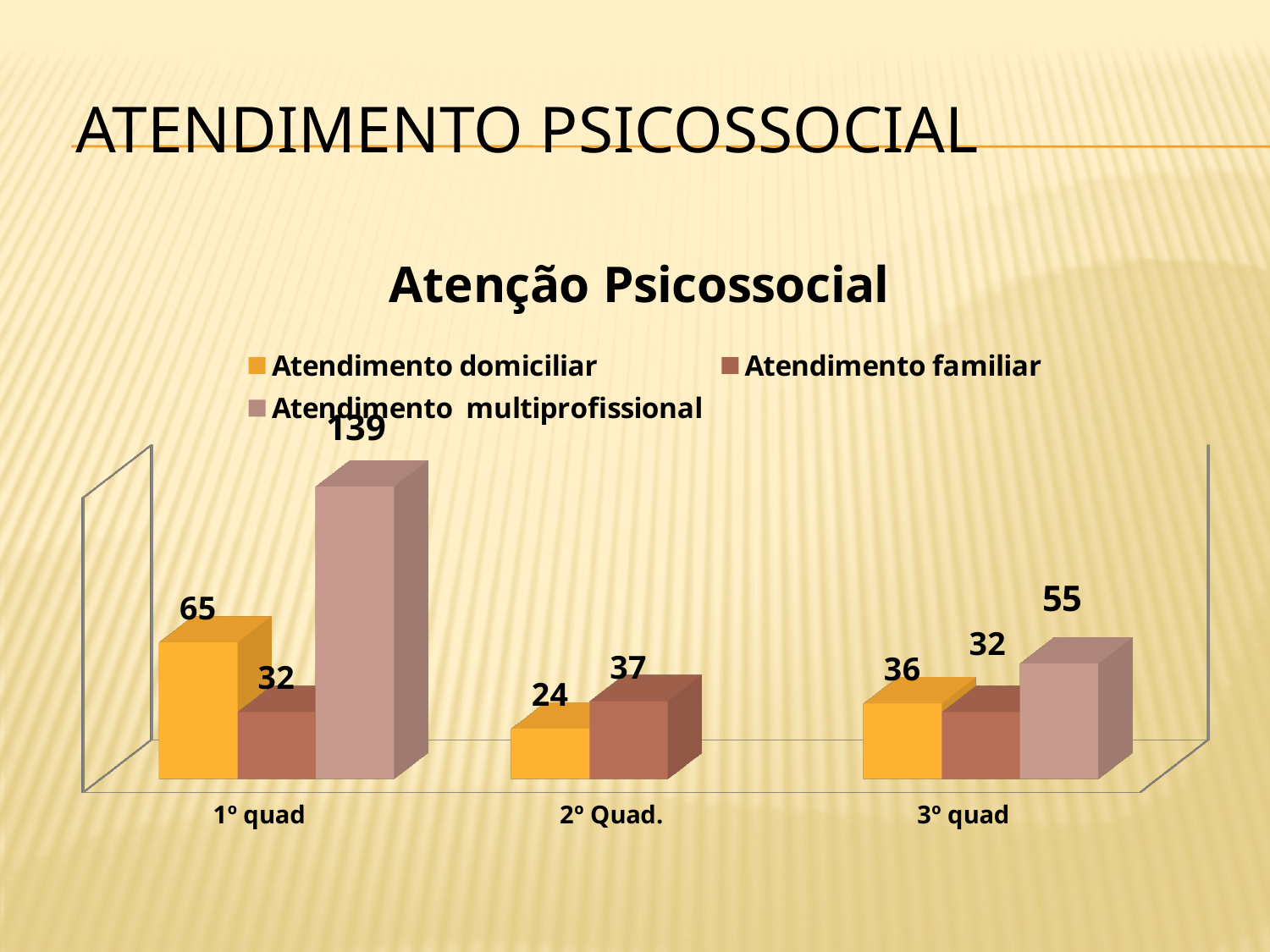
What is the value for Atendimento familiar in 2º Quad.? 37 What is the difference between Atendimento multiprofissional and Atendimento domiciliar in 1º quad? 74 Which category has the lowest value for Atendimento domiciliar? 2º Quad. What is the value for Atendimento multiprofissional in 3º quad? 55 What is the value for Atendimento multiprofissional in 1º quad? 139 Which is larger in 2º Quad., Atendimento domiciliar or Atendimento familiar? Atendimento familiar Which category has the highest value for Atendimento domiciliar? 1º quad How many series does the legend list? 3 What is the title of the chart? Atenção Psicossocial What kind of chart is shown? bar chart How many categories are shown on the x axis? 3 What is the value for Atendimento domiciliar in 1º quad? 65